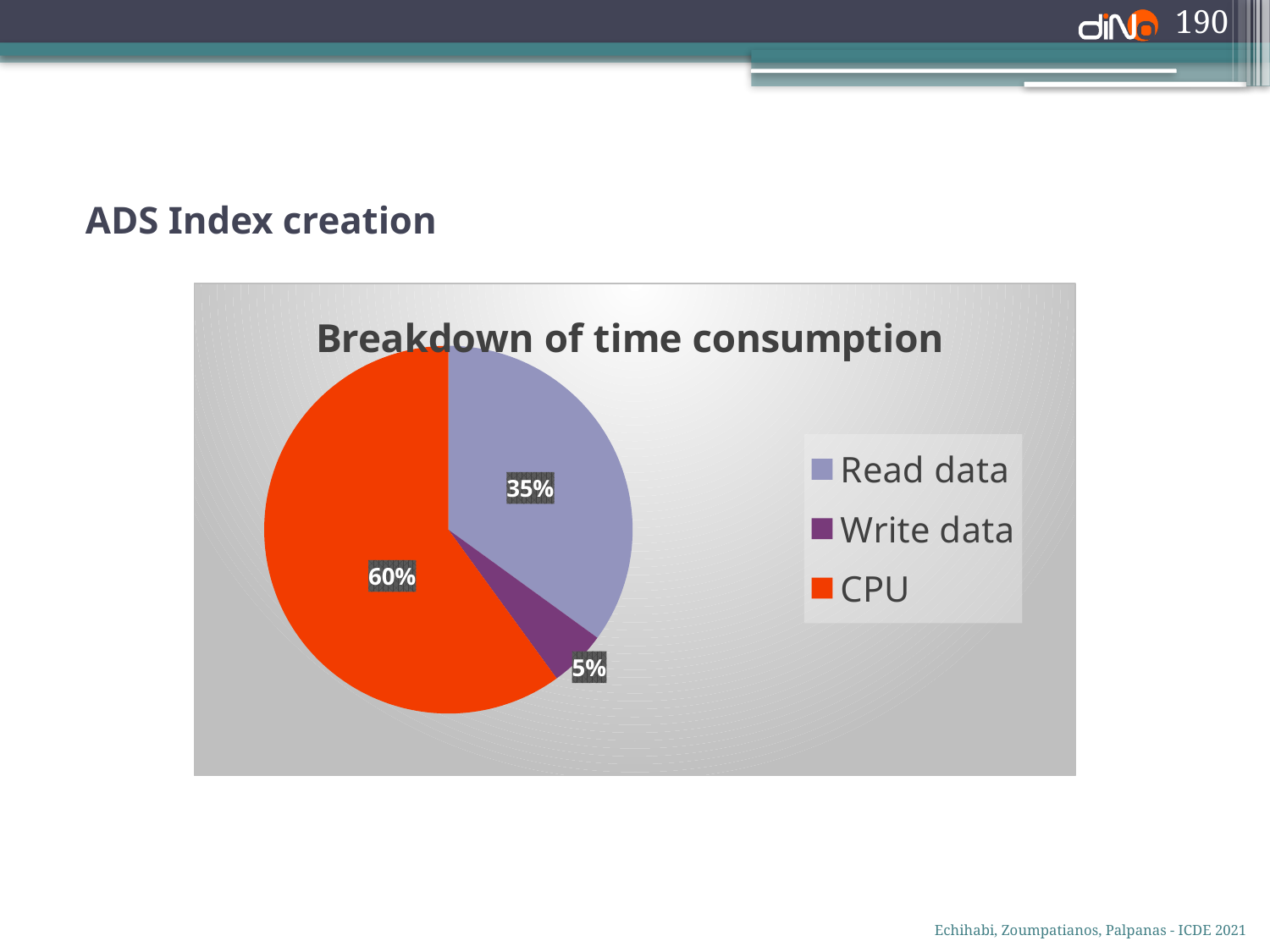
Which category accounts for the smallest share of time consumption? Write data What is the difference in percentage points between the Read data share and the Write data share? 30% What kind of chart is shown on the slide? pie chart What share of time consumption is attributed to Write data? 5% Which is larger, the share for Read data or the share for Write data? Read data What colour represents CPU in the pie chart? orange-red Which category accounts for the largest share of time consumption? CPU What share of time consumption is attributed to Read data? 35% What is the difference in percentage points between the CPU share and the Read data share? 25% How many categories does the pie chart show? 3 What is the title of the chart? Breakdown of time consumption What share of time consumption is attributed to CPU? 60%